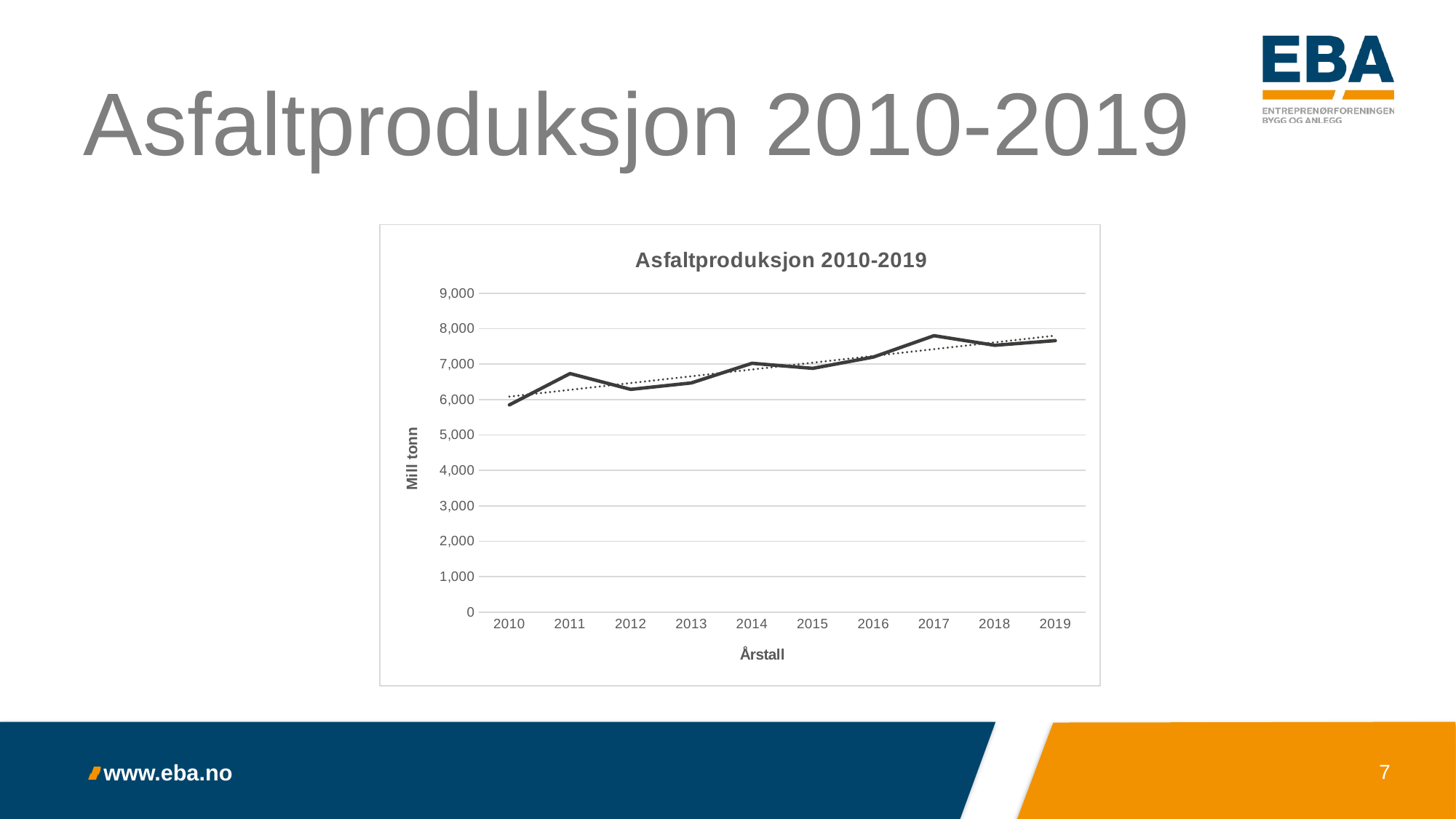
What kind of chart is shown on the slide? Line chart Which year has the highest asphalt production in the chart? 2017 Which year has the larger value, 2017 or 2018? 2017 What is the label on the y axis of the chart? Mill tonn How many years are plotted on the x axis of the chart? 10 Overall, do the values rise or fall from 2010 to 2019? Rise Which year has the lowest asphalt production in the chart? 2010 Which year has the larger value, 2011 or 2012? 2011 Is the value for 2010 greater or less than 6,000? less Is the value for 2019 greater or less than 7,000? greater Is the value for 2017 greater or less than 7,000? greater